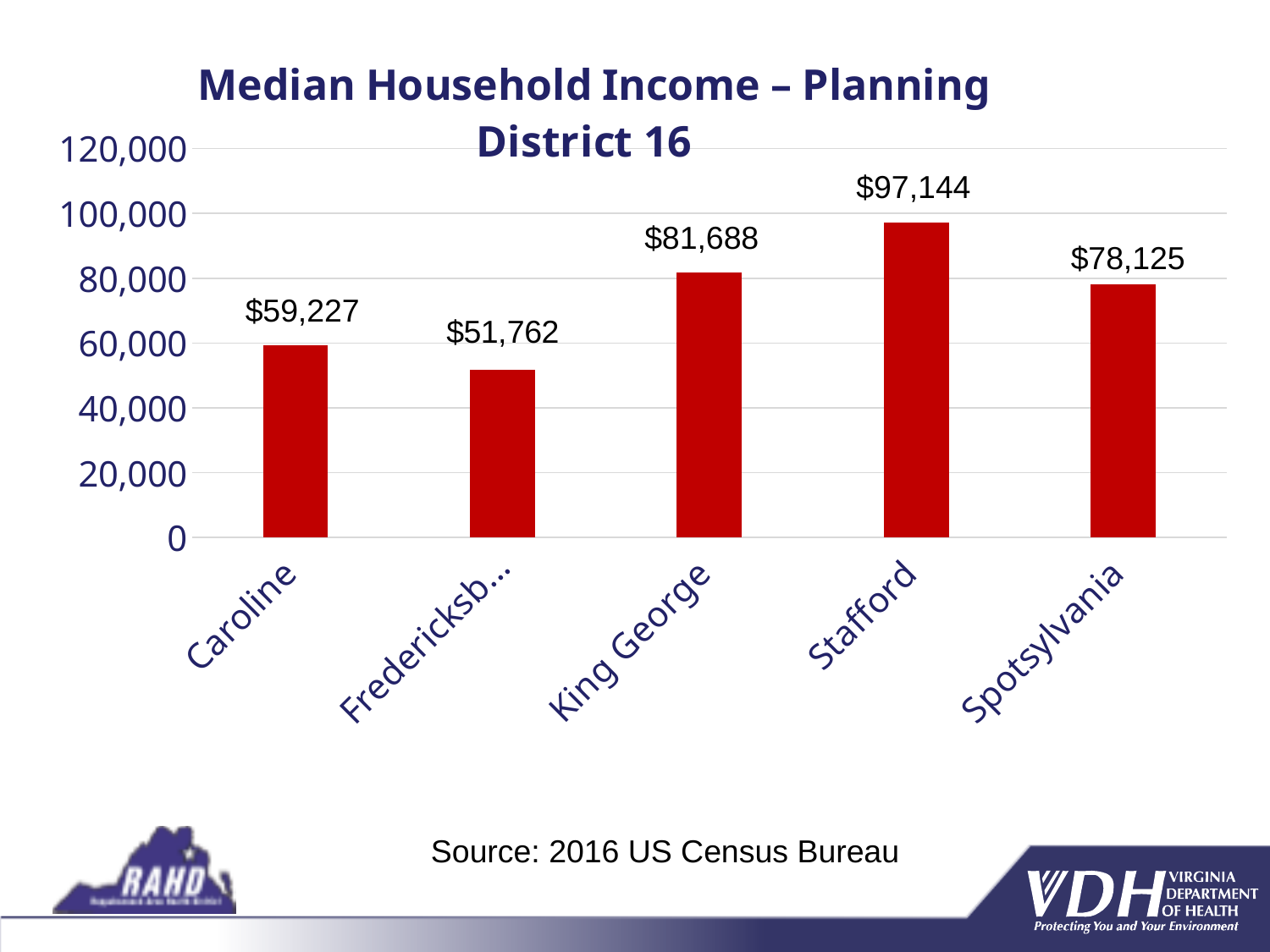
What is the median household income for Spotsylvania? $78,125 What is the difference between the median household income of Stafford and King George? $15,456 What is the difference between the median household income of Spotsylvania and Caroline? $18,898 Is the value for Caroline greater or less than 60,000? less Which category has the highest median household income? Stafford What is the median household income for Caroline? $59,227 What type of chart is shown on the slide? Bar chart What is the title of the chart? Median Household Income – Planning District 16 What is the median household income for King George? $81,688 What is the median household income for Stafford? $97,144 Which has a higher median household income, King George or Spotsylvania? King George How many categories are shown on the x axis? 5